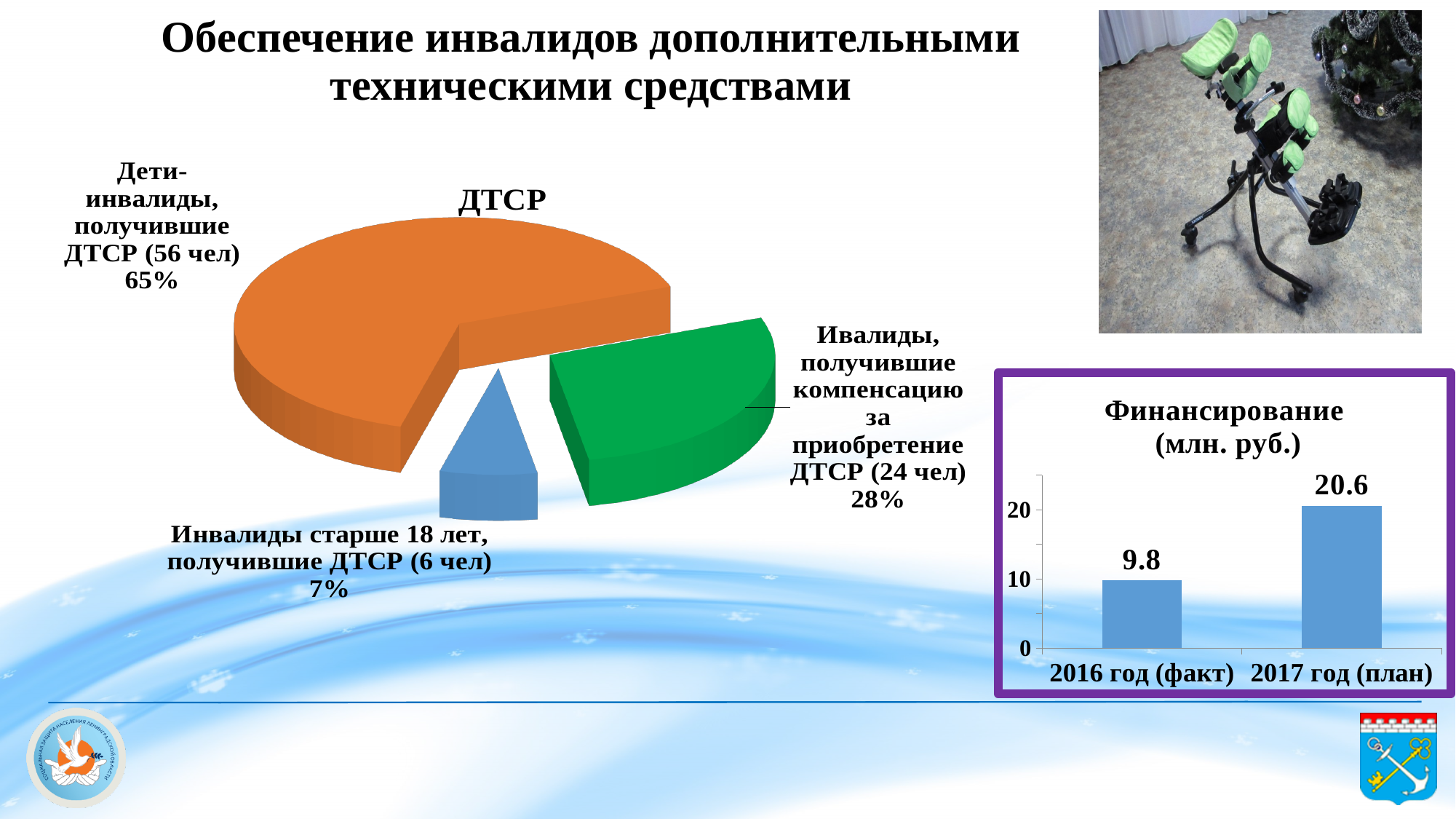
In the pie chart titled ДТСР, which category has the smallest slice? Инвалиды старше 18 лет, получившие ДТСР In the pie chart titled ДТСР, how many people are in the Дети-инвалиды, получившие ДТСР category? 56 чел In the pie chart titled ДТСР, what share is shown for Ивалиды, получившие компенсацию за приобретение ДТСР? 28% In the bar chart titled Финансирование (млн. руб.), what is the difference between the 2017 год (план) and 2016 год (факт) values? 10.8 In the pie chart titled ДТСР, how many slices are there? 3 In the pie chart titled ДТСР, what colour is the slice for Ивалиды, получившие компенсацию за приобретение ДТСР? Green In the bar chart titled Финансирование (млн. руб.), what is the value for 2016 год (факт)? 9.8 In the pie chart titled ДТСР, what share is shown for Инвалиды старше 18 лет, получившие ДТСР? 7% What kind of chart is the one titled Финансирование (млн. руб.)? Bar chart In the pie chart titled ДТСР, which category has the largest slice? Дети-инвалиды, получившие ДТСР In the pie chart titled ДТСР, what share is shown for Дети-инвалиды, получившие ДТСР? 65% In the bar chart titled Финансирование (млн. руб.), what is the value for 2017 год (план)? 20.6